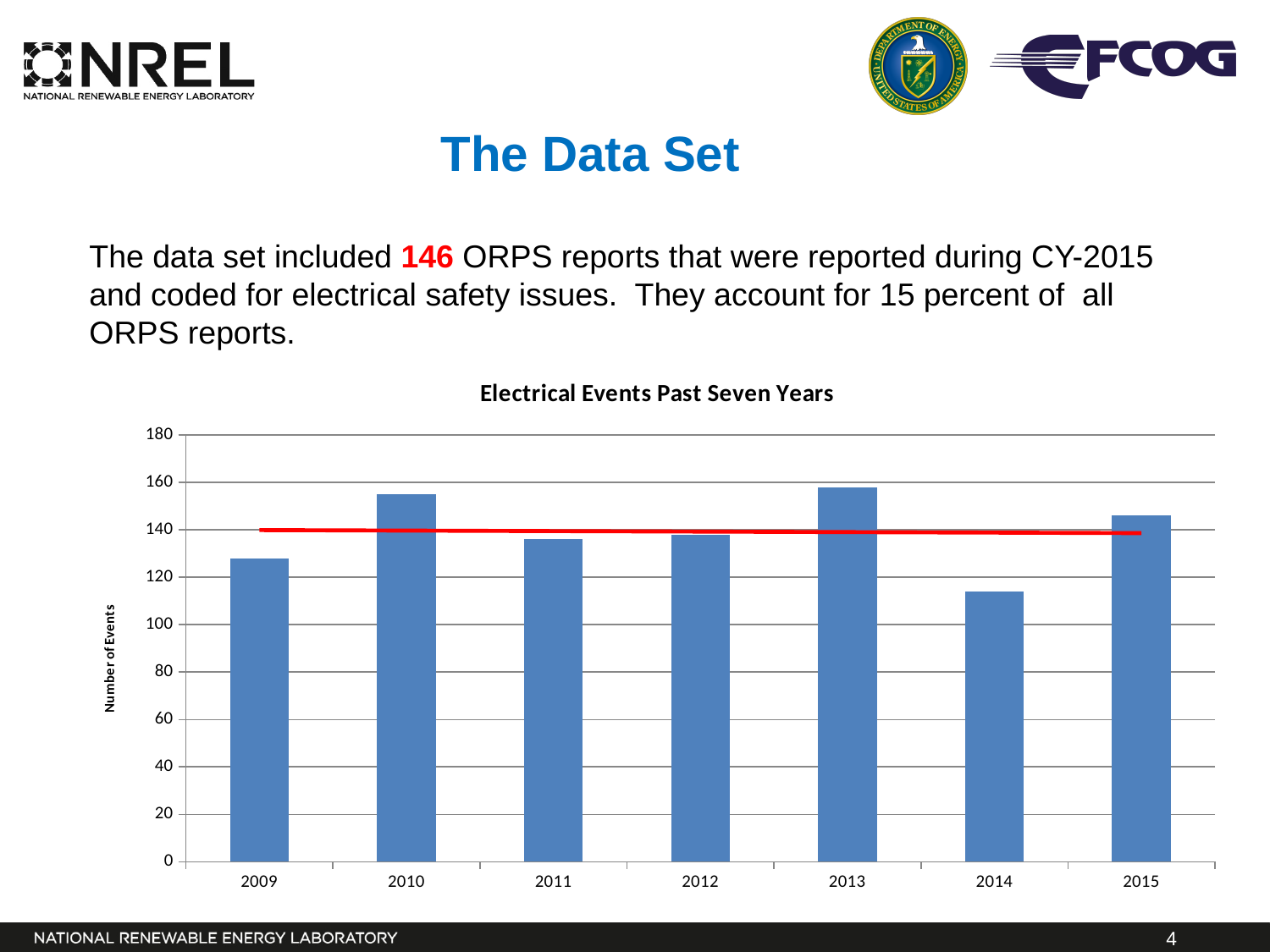
What kind of chart is shown on the slide? bar chart Is the value for 2010 greater or less than 140? greater Is the value for 2014 greater or less than 120? less Is the value for 2015 greater or less than 140? greater What is the title of the chart? Electrical Events Past Seven Years What is the label on the y axis of the chart? Number of Events Which year has more events, 2009 or 2010? 2010 Which year has the lowest number of events in the chart? 2014 How many years are shown on the x axis of the chart? 7 Which year has more events, 2011 or 2014? 2011